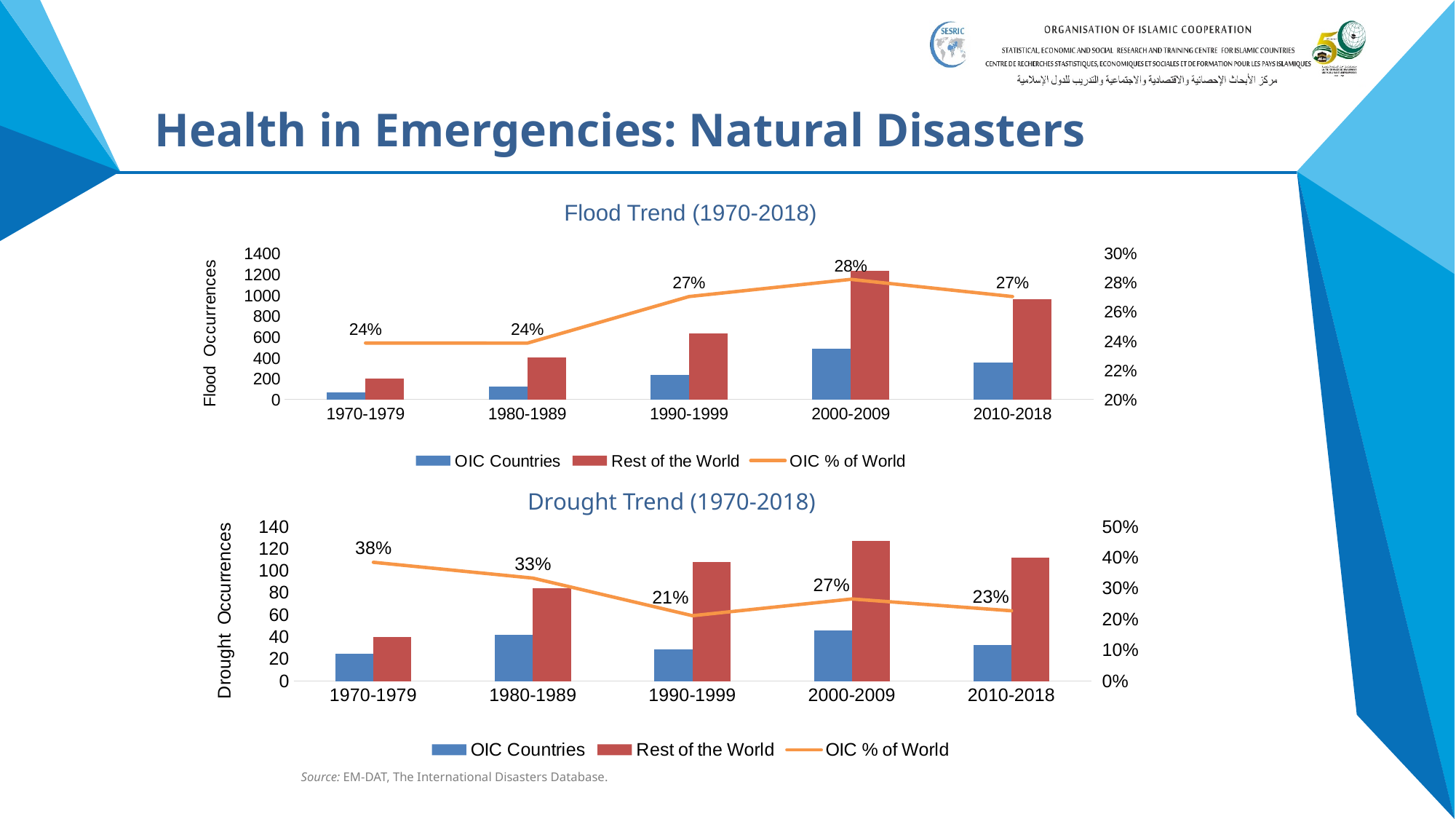
In the Drought Trend (1970-2018) chart, is the Rest of the World value for 2000-2009 greater or less than 100? greater How many series does the legend of the Drought Trend (1970-2018) chart list? 3 In the Flood Trend (1970-2018) chart, is the Rest of the World value for 2010-2018 greater or less than 1000? less In the Drought Trend (1970-2018) chart, what is the OIC % of World for 1980-1989? 33% In the Drought Trend (1970-2018) chart, what is the difference in percentage points between the OIC % of World for 1970-1979 and for 1990-1999? 17 percentage points In the Flood Trend (1970-2018) chart, is the OIC Countries value for 2000-2009 greater or less than 400? greater In the Flood Trend (1970-2018) chart, what is the OIC % of World for 1970-1979? 24% In the Drought Trend (1970-2018) chart, does the OIC % of World rise or fall from 1970-1979 to 1990-1999? fall In the Flood Trend (1970-2018) chart, which period has the highest OIC % of World? 2000-2009 In the Drought Trend (1970-2018) chart, which period has the lowest OIC % of World? 1990-1999 In the Flood Trend (1970-2018) chart, what is the OIC % of World for 2000-2009? 28% In the Drought Trend (1970-2018) chart, which period has the highest OIC % of World? 1970-1979